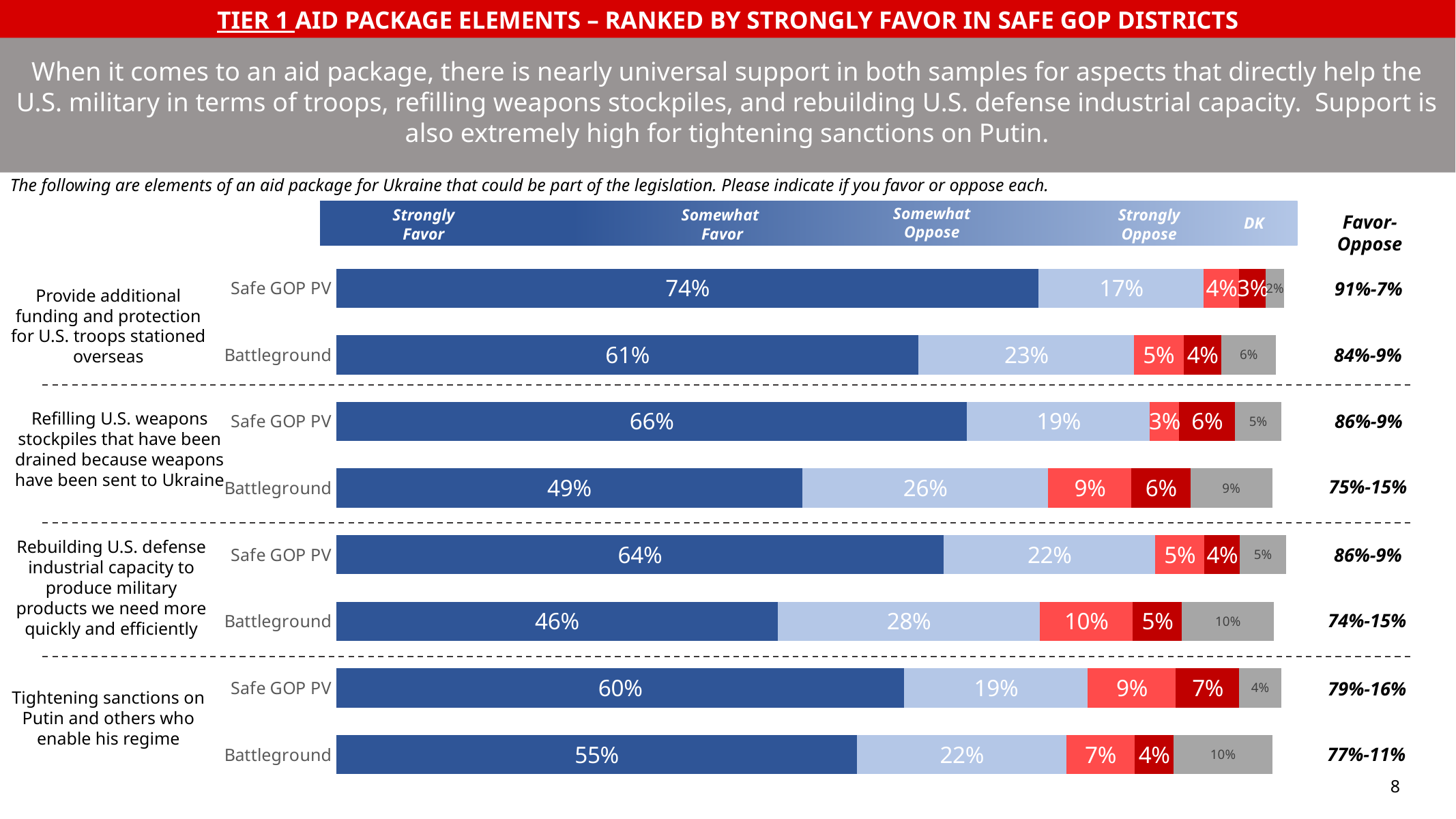
What is the Favor-Oppose figure shown for Safe GOP PV on refilling U.S. weapons stockpiles? 86%-9% How many series does the legend list? 5 For rebuilding U.S. defense industrial capacity, which sample has the larger Somewhat Oppose share, Safe GOP PV or Battleground? Battleground What percentage of Safe GOP PV respondents strongly favor providing additional funding and protection for U.S. troops stationed overseas? 74% What is the combined Somewhat Oppose and Strongly Oppose percentage for Safe GOP PV on tightening sanctions on Putin? 16% For providing additional funding and protection for U.S. troops, how many percentage points higher is Strongly Favor among Safe GOP PV than among Battleground? 13 percentage points How many bars are plotted on the chart? 8 What is the Somewhat Favor value for Battleground respondents on refilling U.S. weapons stockpiles? 26% What is the DK value for Battleground respondents on tightening sanctions on Putin and others who enable his regime? 10% Which bar has the lowest Strongly Favor percentage? Battleground, Rebuilding U.S. defense industrial capacity (46%) What kind of chart is shown on the slide? Stacked horizontal bar chart Which bar has the highest Strongly Favor percentage? Safe GOP PV, Provide additional funding and protection for U.S. troops stationed overseas (74%)